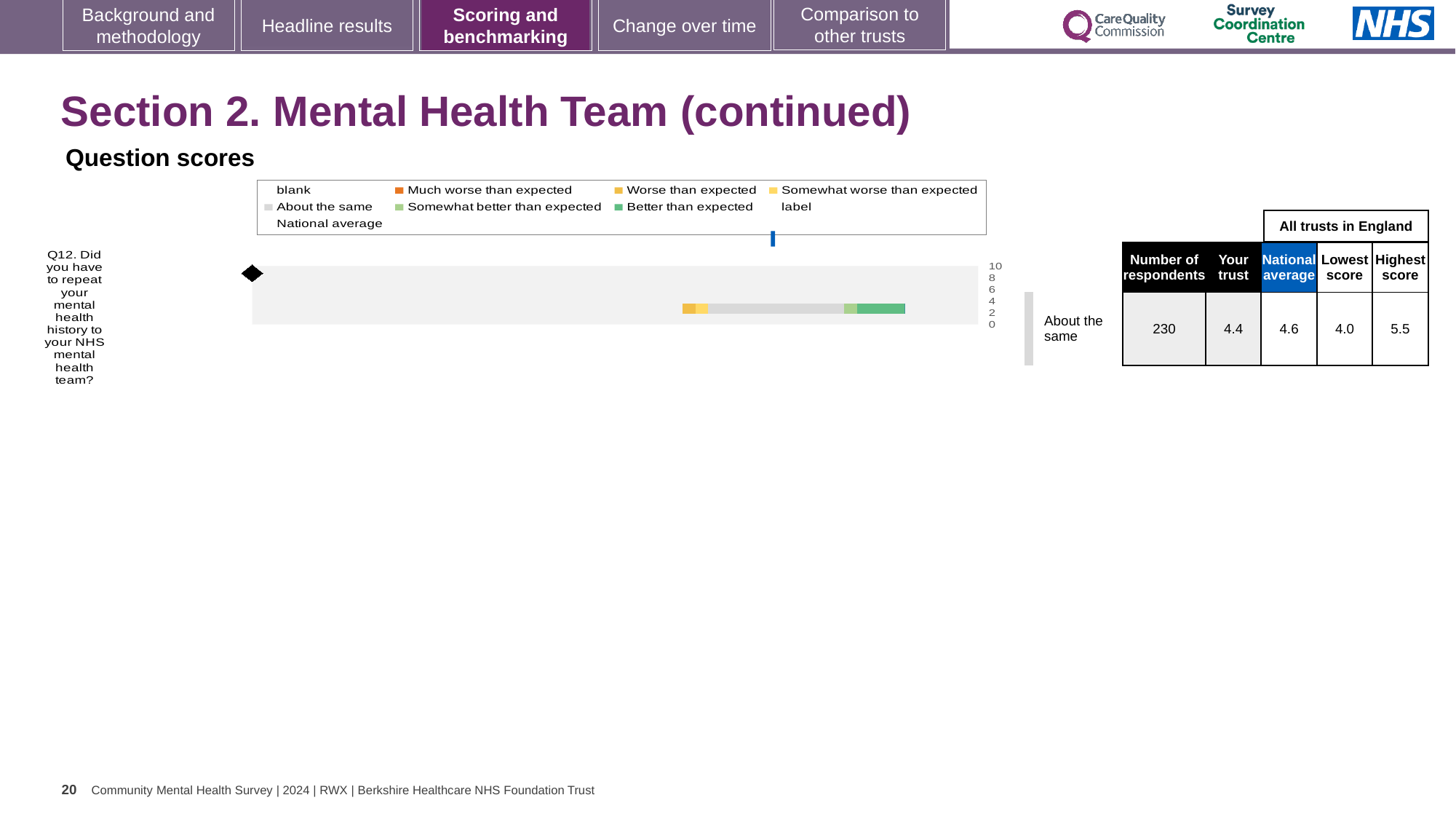
In the table beside the chart, what is the 'Your trust' score for Q12? 4.4 Which question is plotted in the 'Question scores' chart? Q12. Did you have to repeat your mental health history to your NHS mental health team? How many questions (categories) are plotted in the 'Question scores' chart? 1 In the table beside the chart, what is the national average score for Q12? 4.6 How many entries does the legend of the 'Question scores' chart list? 9 In the table beside the chart, which is larger for Q12: the 'Your trust' score or the national average? National average What benchmark category is shown for Q12 next to the chart? About the same In the table beside the chart, what is the number of respondents for Q12? 230 In the legend of the 'Question scores' chart, which colour represents 'Much worse than expected'? Orange In the table beside the chart, what is the highest score among all trusts in England for Q12? 5.5 In the legend of the 'Question scores' chart, which colour represents 'Better than expected'? Green What kind of chart is shown under 'Question scores'? Stacked bar chart